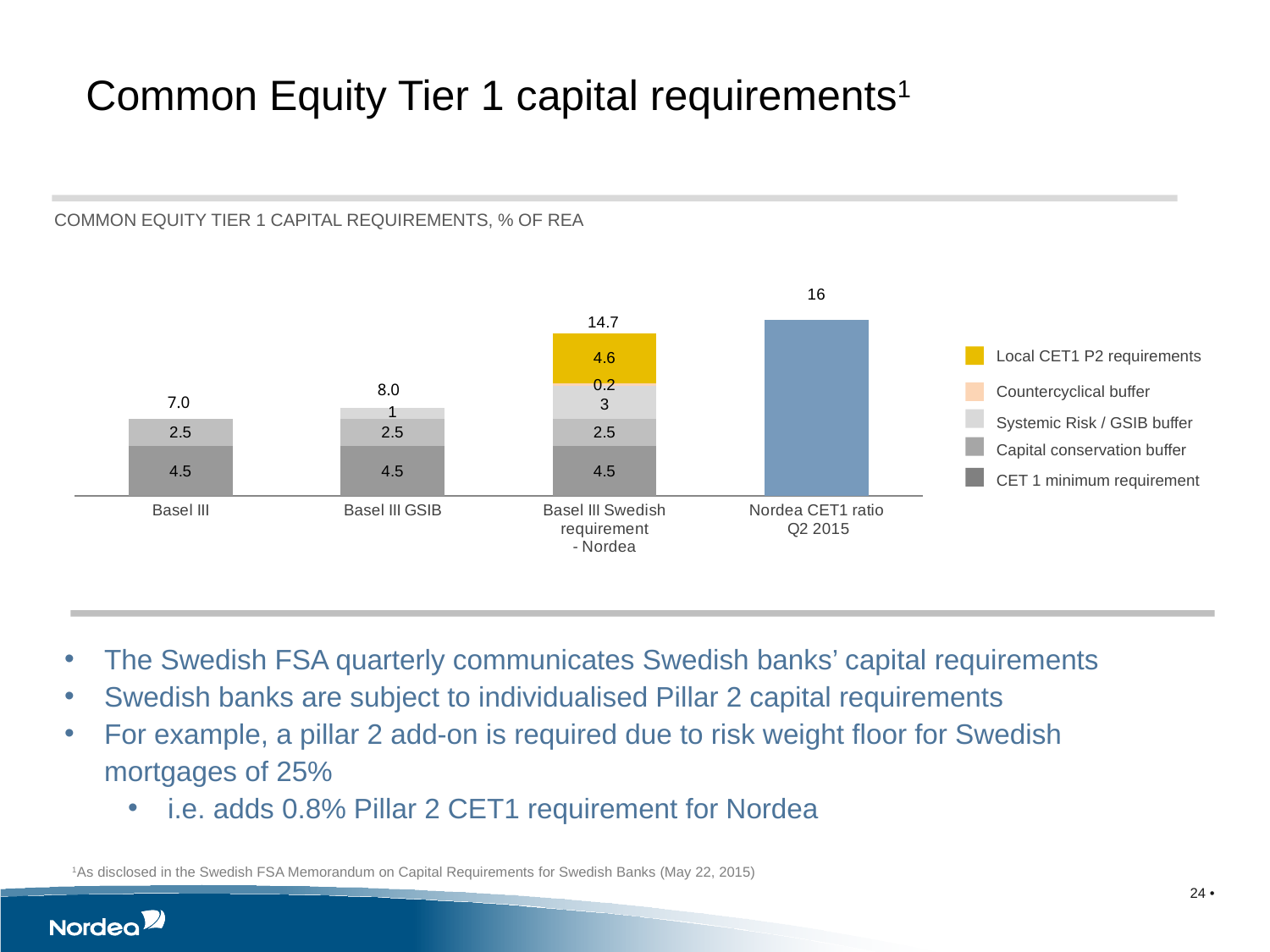
What is the value of the Nordea CET1 ratio Q2 2015 bar? 16 Which bar has the highest total value? Nordea CET1 ratio Q2 2015 What is the difference between the Nordea CET1 ratio Q2 2015 bar and the Basel III Swedish requirement - Nordea total? 1.3 What kind of chart is shown on the slide? Stacked bar chart What is the total value shown for the Basel III bar? 7.0 Which bar has the lowest total value? Basel III How many bars (categories) are shown on the x axis? 4 What is the CET 1 minimum requirement segment value in the Basel III GSIB bar? 4.5 What is the Systemic Risk / GSIB buffer segment value in the Basel III GSIB bar? 1 What is the total value shown for the Basel III Swedish requirement - Nordea bar? 14.7 How many series does the legend list? 5 What is the Local CET1 P2 requirements segment value in the Basel III Swedish requirement - Nordea bar? 4.6